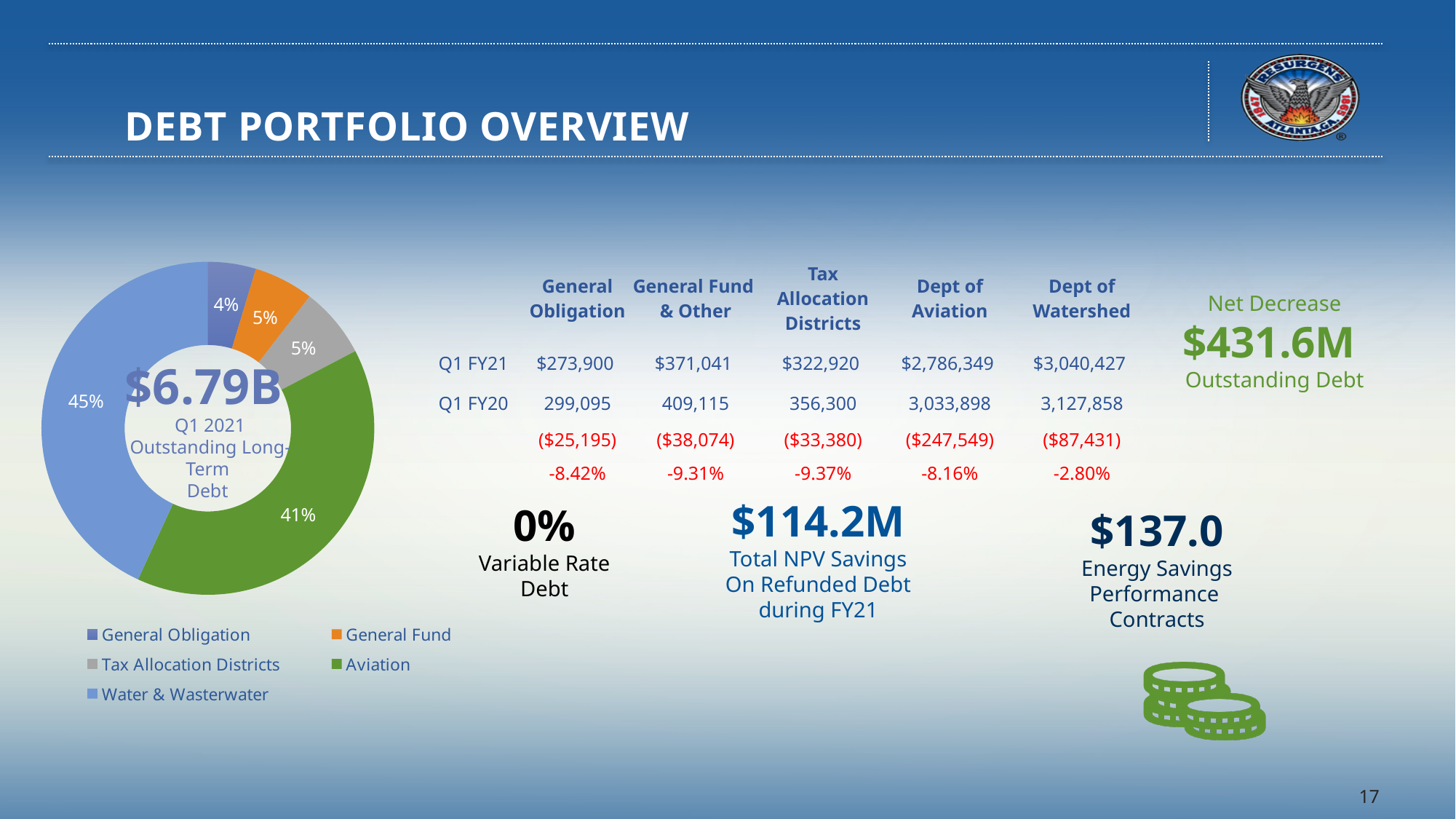
Which is larger in the pie chart, Aviation or General Fund? Aviation What percentage of the pie chart is General Fund? 5% What percentage of the pie chart is General Obligation? 4% What percentage of the pie chart is Tax Allocation Districts? 5% What total value is printed in the center of the donut chart? $6.79B Which category has the largest slice in the pie chart? Water & Wastewater How many categories are shown in the pie chart? 5 What percentage of the pie chart is Aviation? 41% What share of the donut chart does Water & Wastewater represent? 45% By how many percentage points does the Water & Wastewater slice exceed the Aviation slice? 4 percentage points Which category has the smallest slice in the pie chart? General Obligation What kind of chart is shown on the left of the slide? Pie chart (donut)